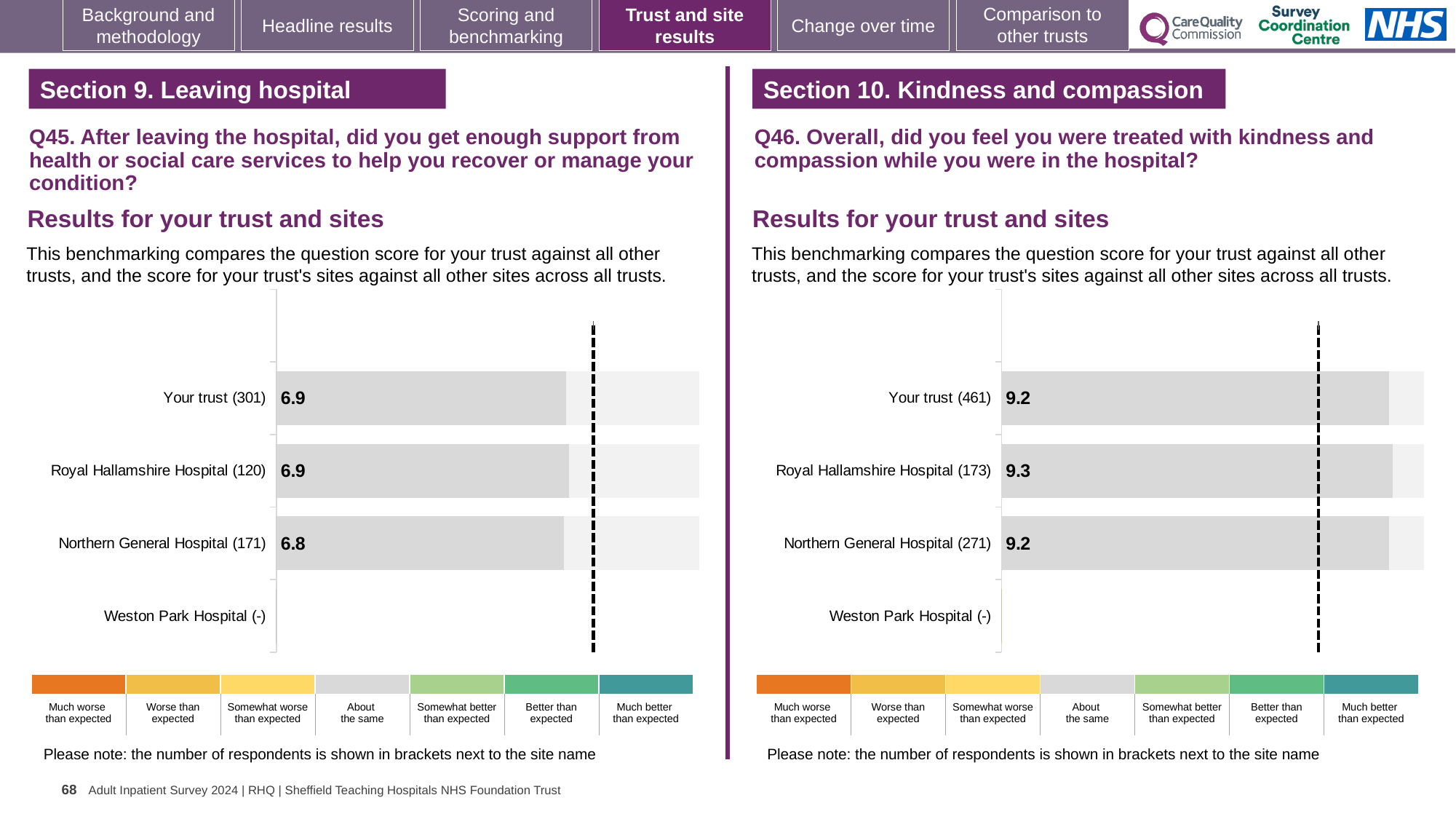
In the Q46 chart on the right, which is larger: the score for Royal Hallamshire Hospital or the score for Northern General Hospital? Royal Hallamshire Hospital In the Q45 chart on the left, which site has the lowest printed score? Northern General Hospital In the Q46 chart on the right, what is the score for Northern General Hospital? 9.2 In the Q46 chart on the right, what is the score for Royal Hallamshire Hospital? 9.3 In the Q45 chart on the left, how many respondents are shown in brackets for Royal Hallamshire Hospital? 120 In the Q45 chart on the left, what is the score for Northern General Hospital? 6.8 What kind of chart is used for the Q46 results on the right? Bar chart In the Q46 chart on the right, which site has the highest score? Royal Hallamshire Hospital How many site rows (including Your trust) are listed in the Q45 chart on the left? 4 In the Q45 chart on the left, what is the score for Your trust? 6.9 In the Q46 chart on the right, what is the difference between the score for Royal Hallamshire Hospital and the score for Your trust? 0.1 In the Q45 chart on the left, what is the difference between the score for Your trust and the score for Northern General Hospital? 0.1